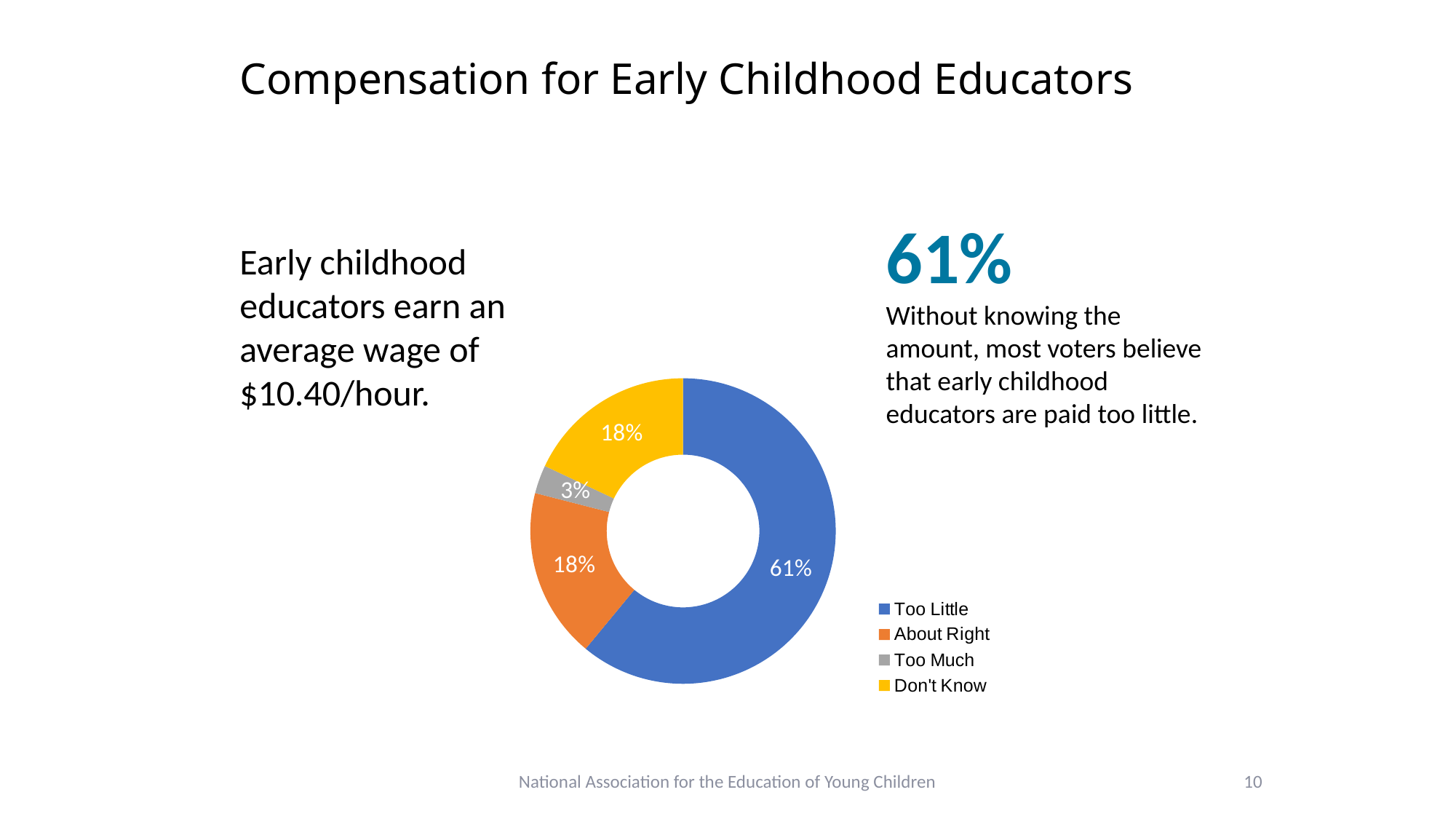
Which category has the smallest slice? Too Much What share of the chart is labelled "Don't Know"? 18% How many categories does the legend list? 4 Which is larger, the "About Right" slice or the "Too Much" slice? About Right What colour is the "Don't Know" slice? Yellow What share of the chart is labelled "Too Much"? 3% What is the difference between the "Too Little" and "About Right" shares? 43 percentage points What share of the chart is labelled "Too Little"? 61% Which category has the largest slice? Too Little What share of the chart is labelled "About Right"? 18% What colour is the "Too Little" slice? Blue What kind of chart is shown on the slide? Doughnut (pie) chart